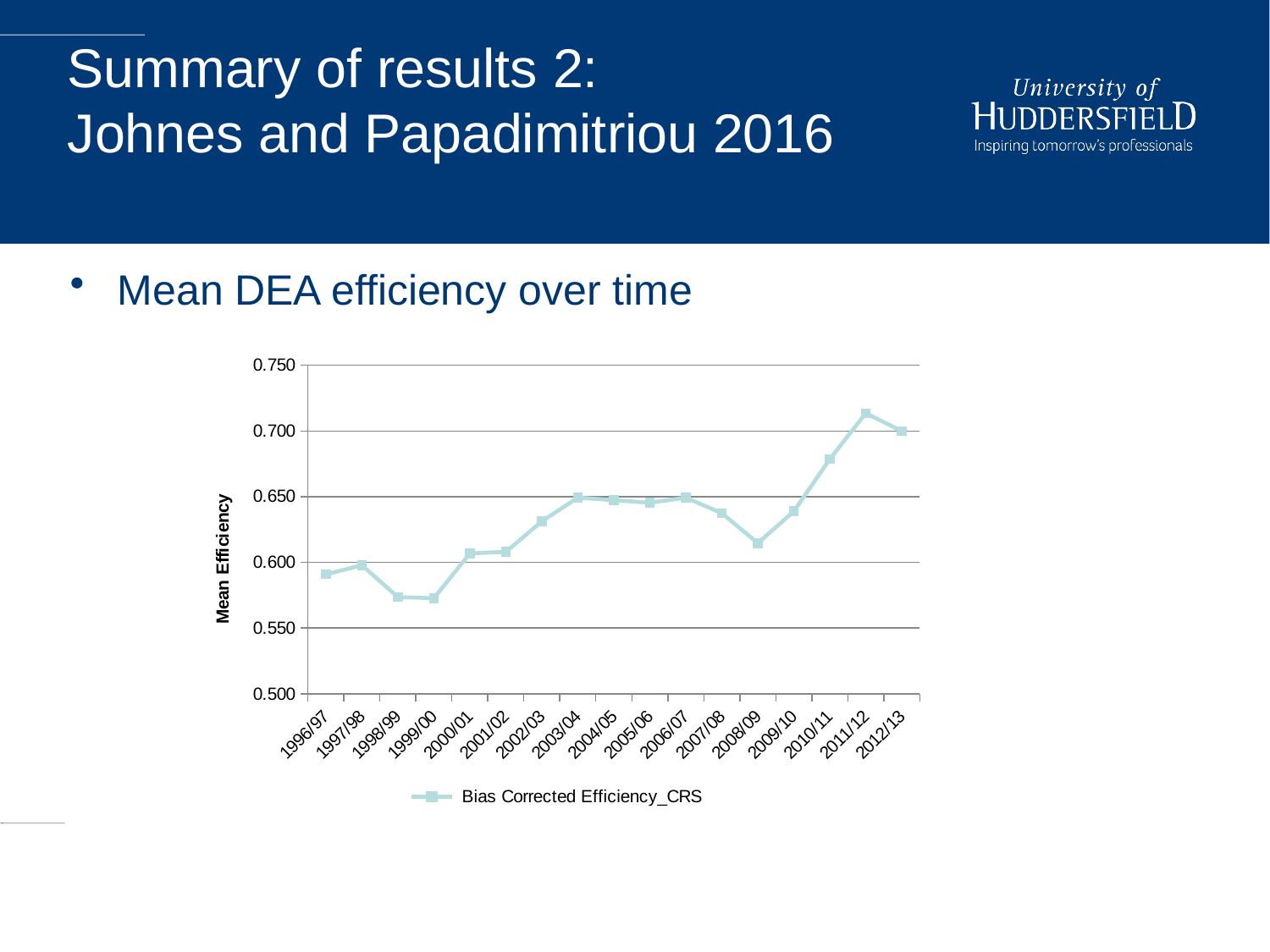
Which has the higher mean efficiency, 2002/03 or 1997/98? 2002/03 What is the series name shown in the chart's legend? Bias Corrected Efficiency_CRS Is the mean efficiency for 2010/11 greater or less than 0.650? greater How many academic years are plotted on the x axis of the chart? 17 Is the mean efficiency for 2011/12 greater or less than 0.700? greater Which academic year has the highest mean efficiency in the chart? 2011/12 How many series does the chart's legend list? 1 Is the mean efficiency for 2008/09 greater or less than 0.650? less Which has the higher mean efficiency, 2010/11 or 2008/09? 2010/11 What kind of chart is shown on the slide? line chart Overall, does mean efficiency rise or fall from 1996/97 to 2012/13? rise